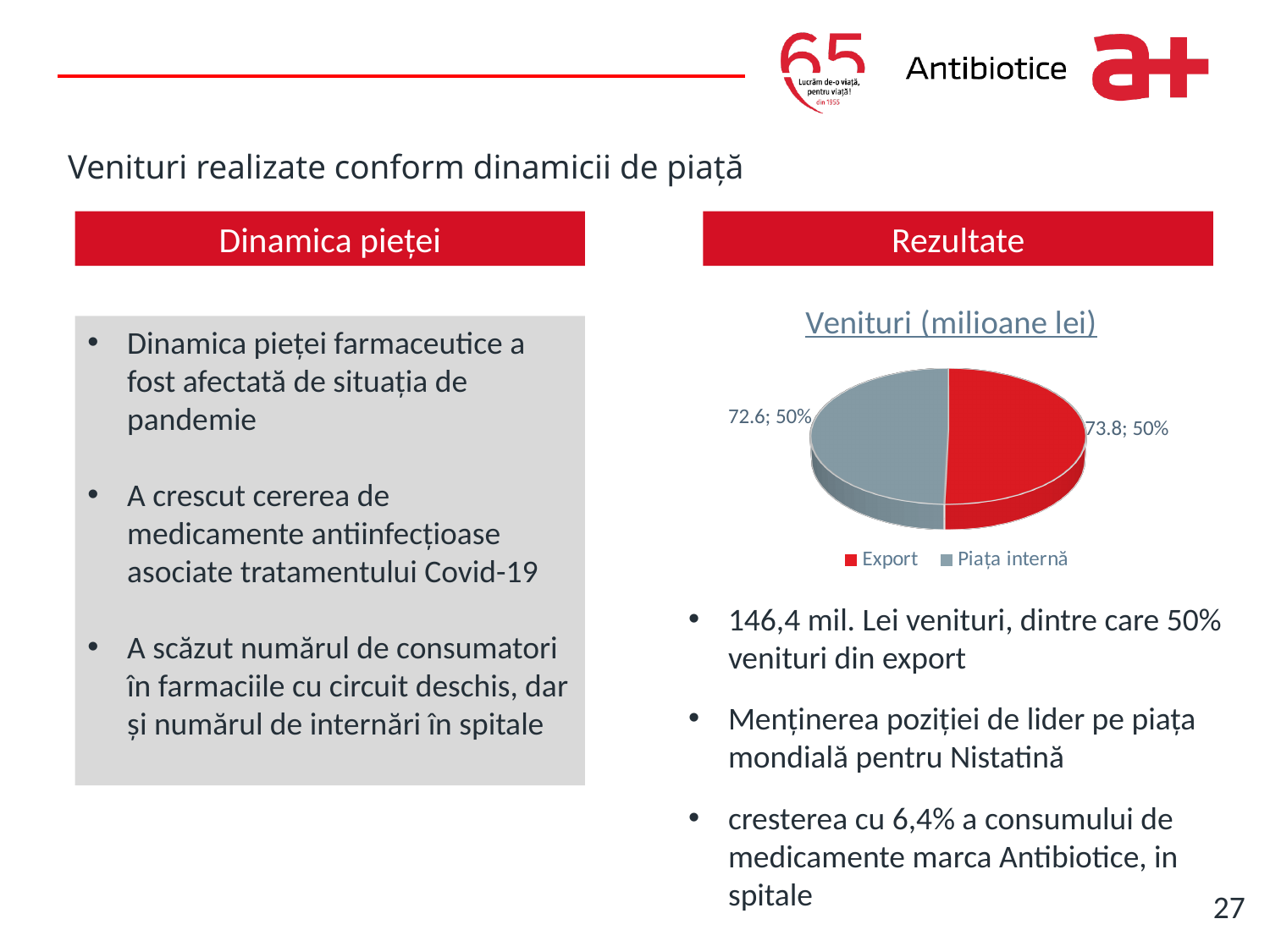
What is the value for Export in the pie chart? 73.8 How many entries does the chart legend list? 2 What is the title of the chart? Venituri (milioane lei) Which category has the highest value in the pie chart? Export Which slice has the larger value, Export or Piața internă? Export What is the difference between the Export value and the Piața internă value? 1.2 How many slices does the pie chart have? 2 What share of the pie does Export represent? 50% What share of the pie does Piața internă represent? 50% Which category has the lowest value in the pie chart? Piața internă What is the value for Piața internă in the pie chart? 72.6 What type of chart is shown on the slide? Pie chart